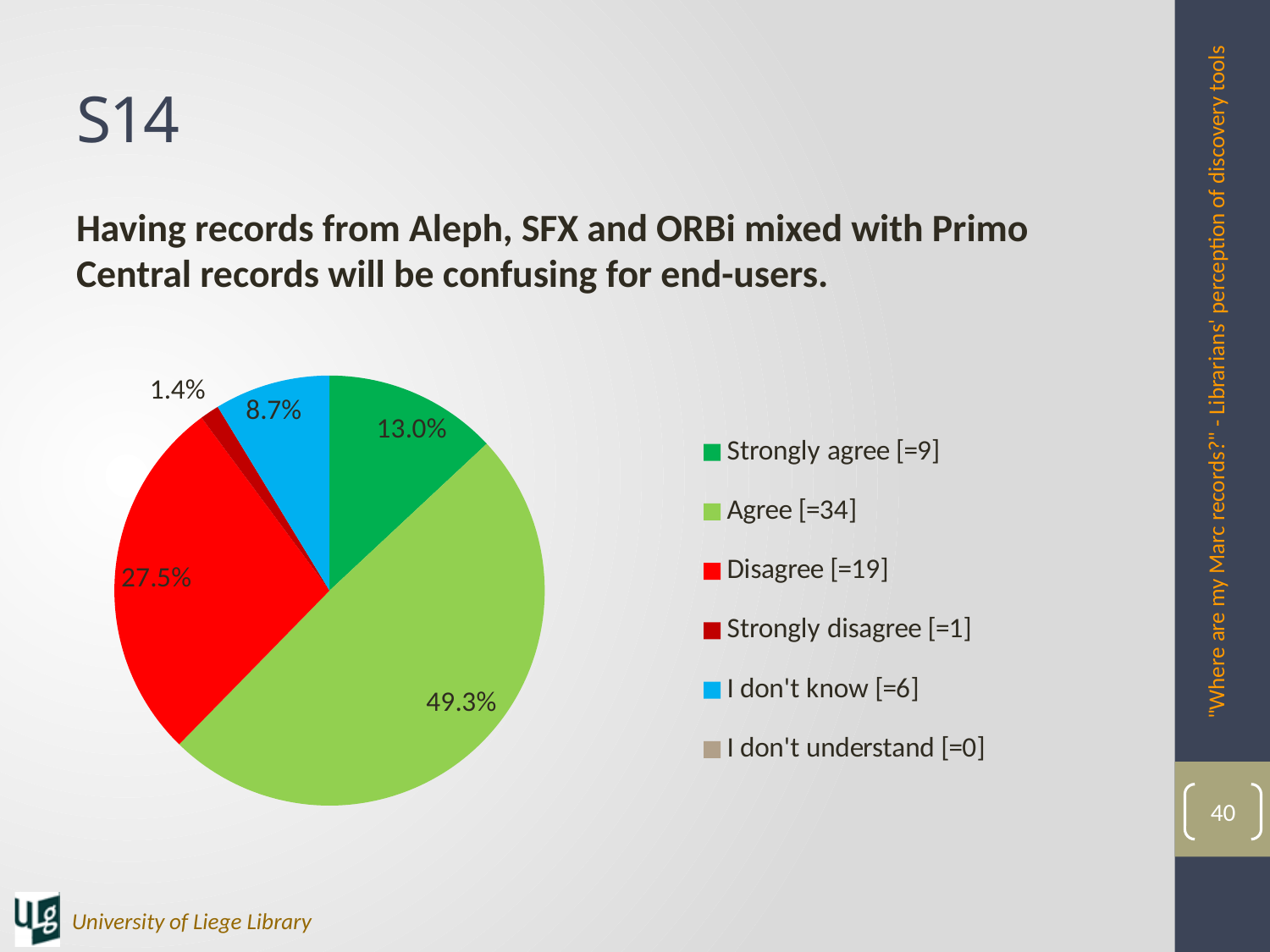
What percentage is shown for the Strongly disagree slice? 1.4% Which response category has the largest slice of the pie? Agree What percentage is shown for the I don't know slice? 8.7% What percentage is shown for the Disagree slice? 27.5% How many entries does the legend list? 6 Which response category with a visible slice has the smallest share of the pie? Strongly disagree What percentage is shown for the Strongly agree slice? 13.0% What share of the pie does the Agree slice represent? 49.3% What kind of chart is shown on the slide? Pie chart Which slice is larger, Strongly agree or I don't know? Strongly agree According to the legend, how many respondents chose Agree? 34 What is the difference in percentage points between the Agree and Disagree slices? 21.8